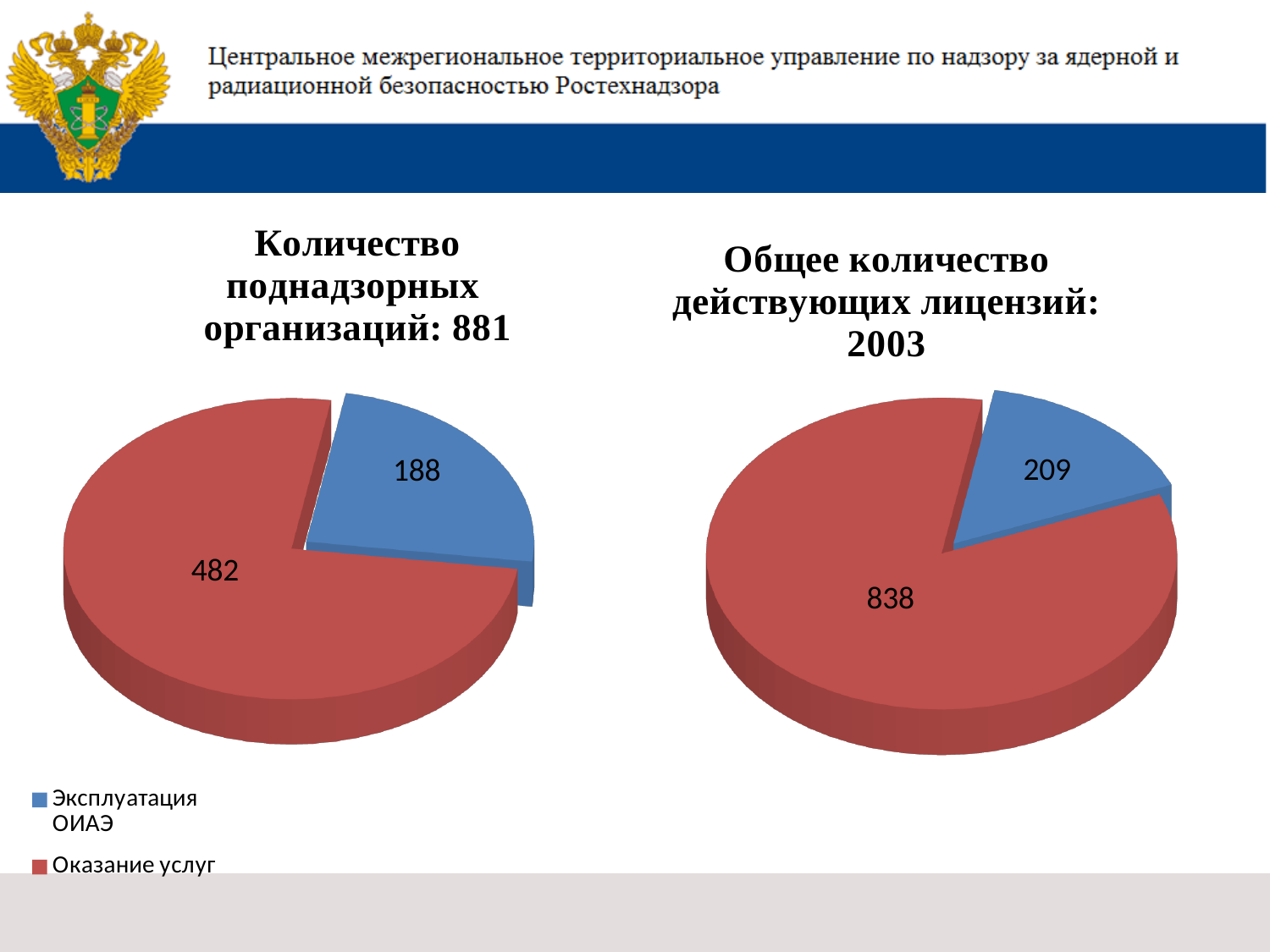
On the left chart, what is the difference between the values for Оказание услуг and Эксплуатация ОИАЭ? 294 How many slices does the right chart have? 2 What kind of chart is used on the left of the slide? Pie chart On the right chart, which category has the smallest slice? Эксплуатация ОИАЭ On the left chart (Количество поднадзорных организаций), what is the value for Эксплуатация ОИАЭ? 188 On the left chart, which category has the largest slice? Оказание услуг On the right chart (Общее количество действующих лицензий), what is the value for Эксплуатация ОИАЭ? 209 Is the value for Эксплуатация ОИАЭ larger on the left chart or on the right chart? Right chart On the left chart (Количество поднадзорных организаций), what is the value for Оказание услуг? 482 On the right chart (Общее количество действующих лицензий), what is the value for Оказание услуг? 838 How many entries does the legend list? 2 On the right chart, what is the difference between the values for Оказание услуг and Эксплуатация ОИАЭ? 629